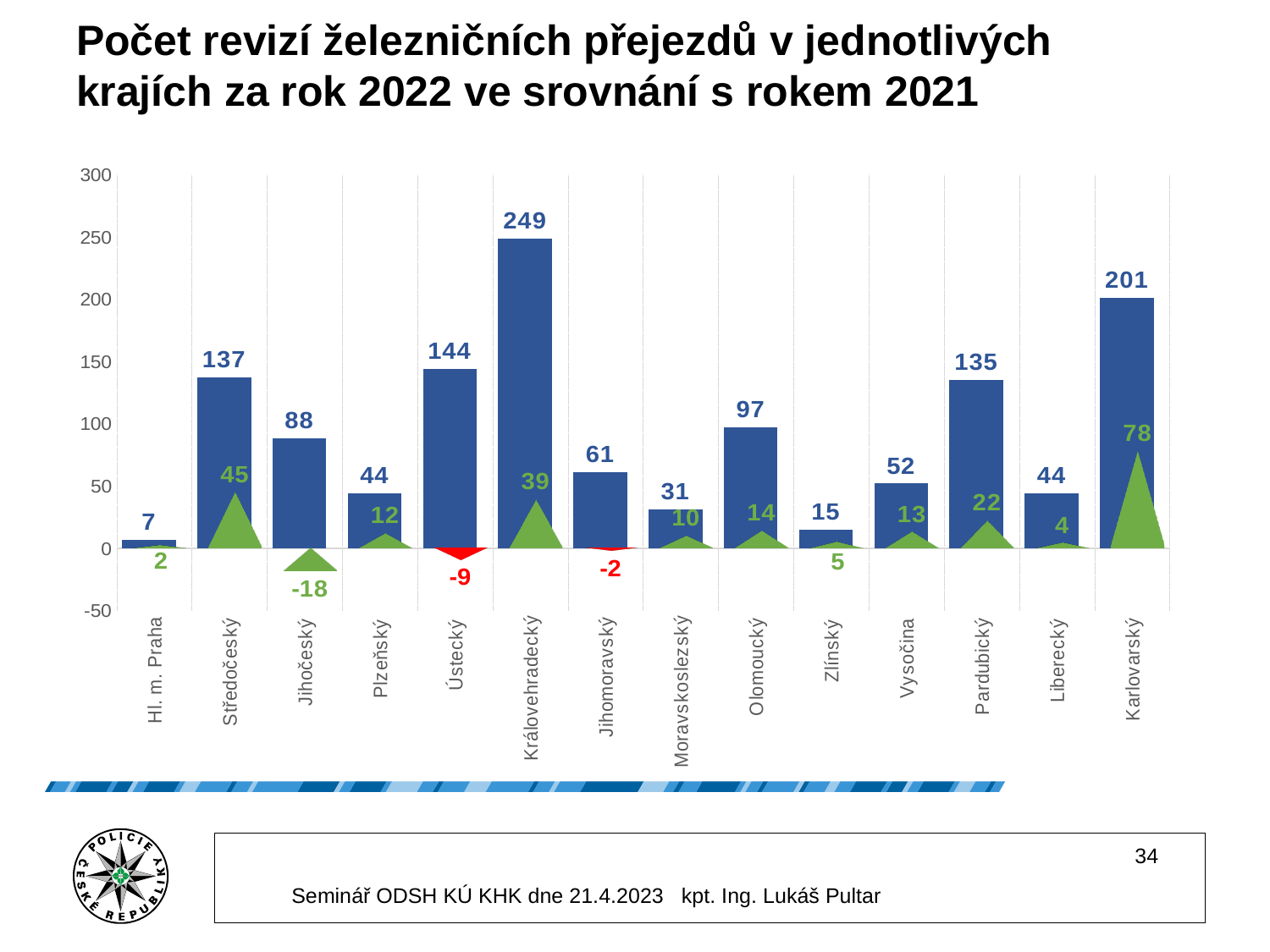
How many regions have a negative (red) difference value? 3 Which region has the lowest blue bar value? Hl. m. Praha How many regions are shown on the x axis? 14 What is the value of the blue bar for Karlovarský? 201 Which region has the highest blue bar value? Královehradecký What is the green/red difference value shown for Jihočeský? -18 What is the green difference value shown for Karlovarský? 78 What is the difference between the blue bar values for Královehradecký and Karlovarský? 48 Which has a larger blue bar value, Středočeský or Pardubický? Středočeský What type of chart is used for the blue values? Bar chart What is the value of the blue bar for Královehradecký? 249 What is the blue bar value for Olomoucký? 97